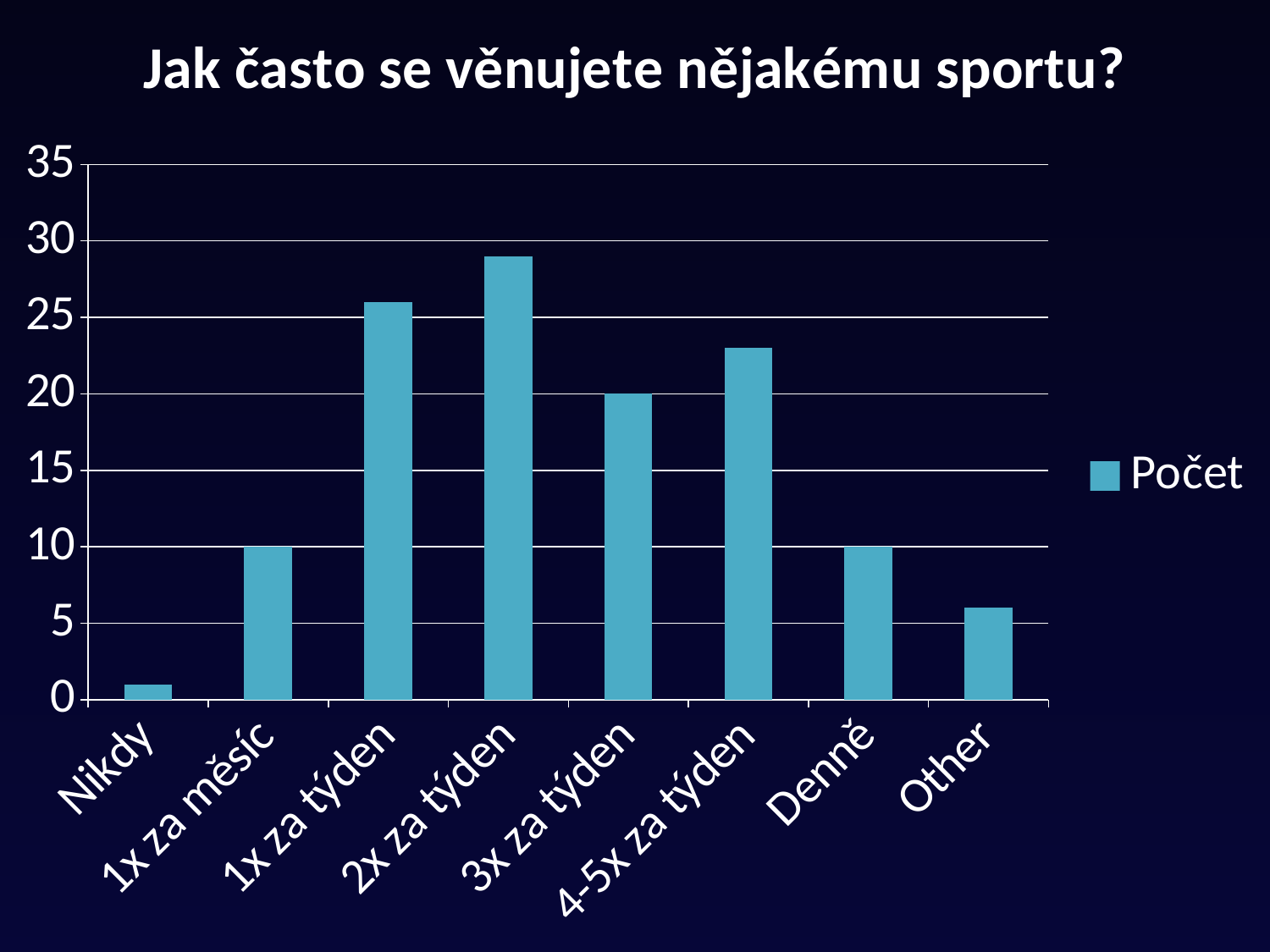
What is the value for 3x za týden? 20 Which is larger, the value for 4-5x za týden or the value for 3x za týden? 4-5x za týden Which category has the lowest value? Nikdy What is the difference between the values for 3x za týden and Denně? 10 What kind of chart is shown on the slide? bar chart What is the value for Denně? 10 How many categories are shown on the x axis? 8 How many series does the legend list? 1 What is the title of the chart? Jak často se věnujete nějakému sportu? Which category has the highest value? 2x za týden Is the value for 1x za týden greater or less than 25? greater Is the value for Other greater or less than 10? less